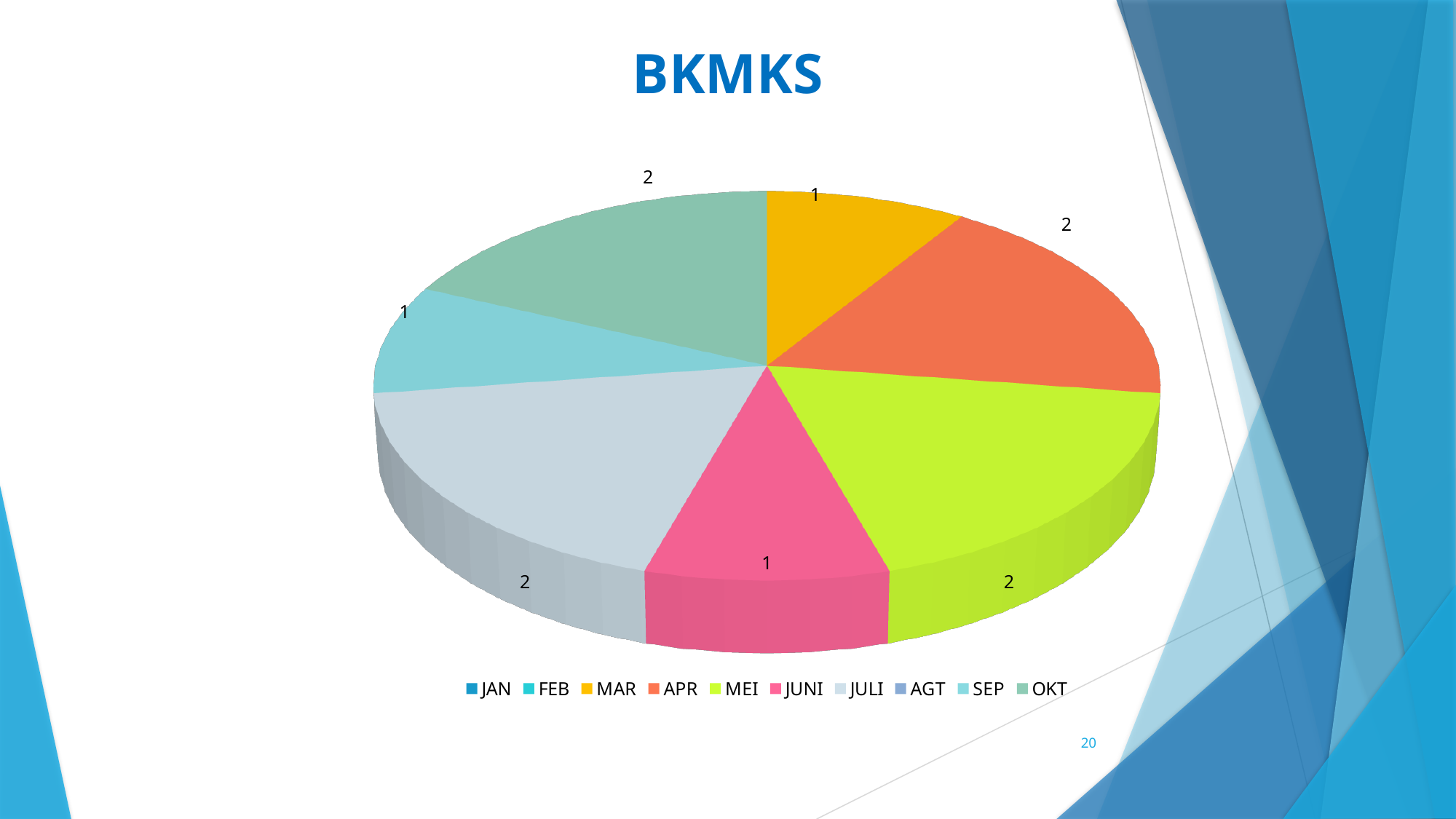
What is the title of the chart? BKMKS What is the difference between the APR value and the MAR value? 1 What is the value of the JUNI slice? 1 How many slices with data labels are visible in the pie? 7 What is the value of the JULI slice? 2 What is the value of the APR slice? 2 What is the value of the SEP slice? 1 What is the value of the MAR slice? 1 What is the value of the OKT slice? 2 What type of chart is shown on the slide? pie chart Which is larger, the MEI slice or the JUNI slice? MEI How many entries does the legend list? 10